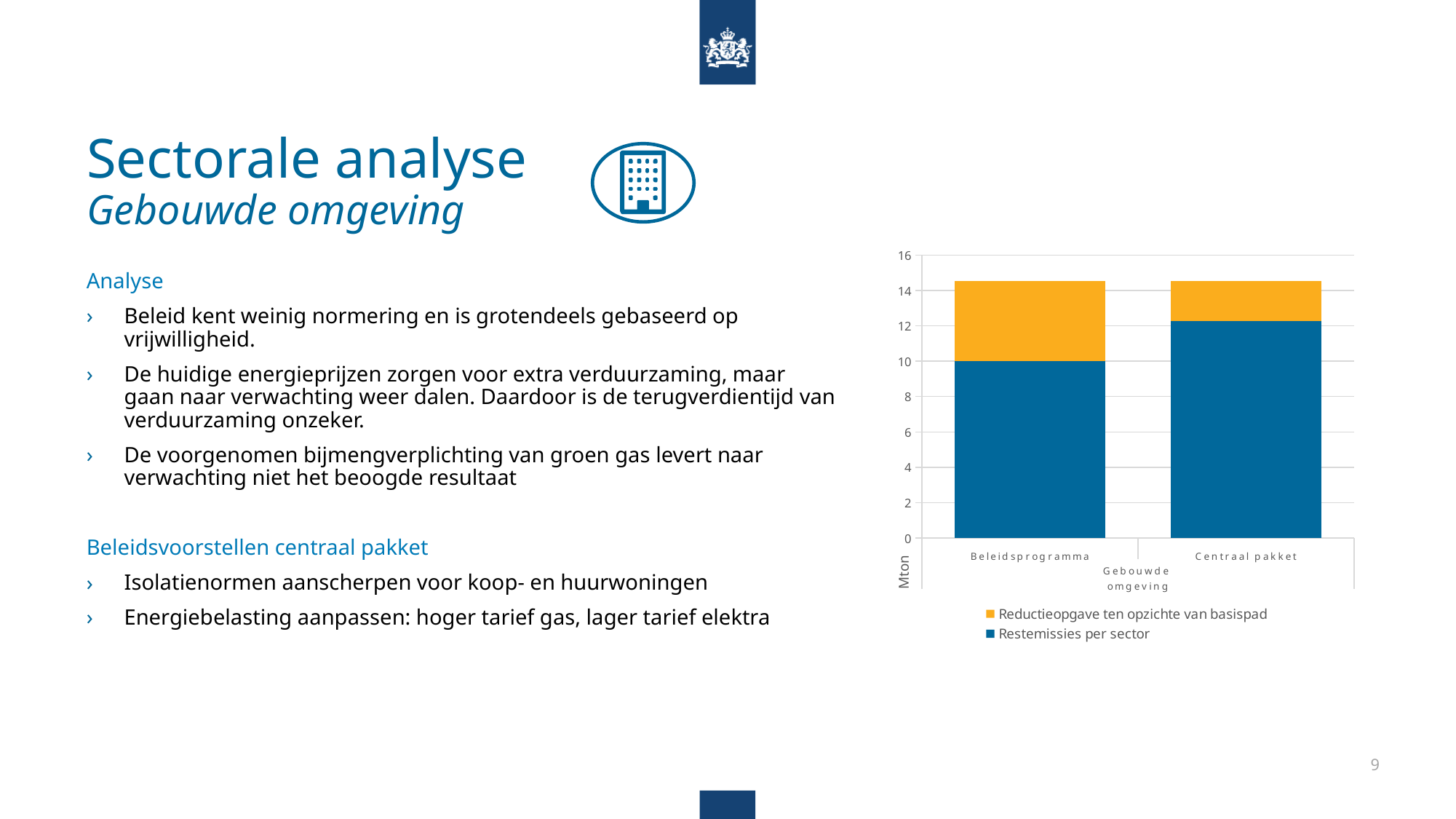
Which category has the larger Reductieopgave ten opzichte van basispad segment, Beleidsprogramma or Centraal pakket? Beleidsprogramma How many bars (categories) are plotted in the chart? 2 Is the Restemissies per sector value for Centraal pakket greater or less than 10? greater Which colour represents Restemissies per sector in the chart? blue Is the total height of the Beleidsprogramma bar greater or less than 14? greater What is the value of Restemissies per sector for Beleidsprogramma? 10 Is the Reductieopgave ten opzichte van basispad segment for Centraal pakket greater or less than 4? less Which category has the larger Restemissies per sector value, Beleidsprogramma or Centraal pakket? Centraal pakket How many series does the chart legend list? 2 What kind of chart is shown on the slide? stacked bar chart What unit is shown on the vertical axis of the chart? Mton